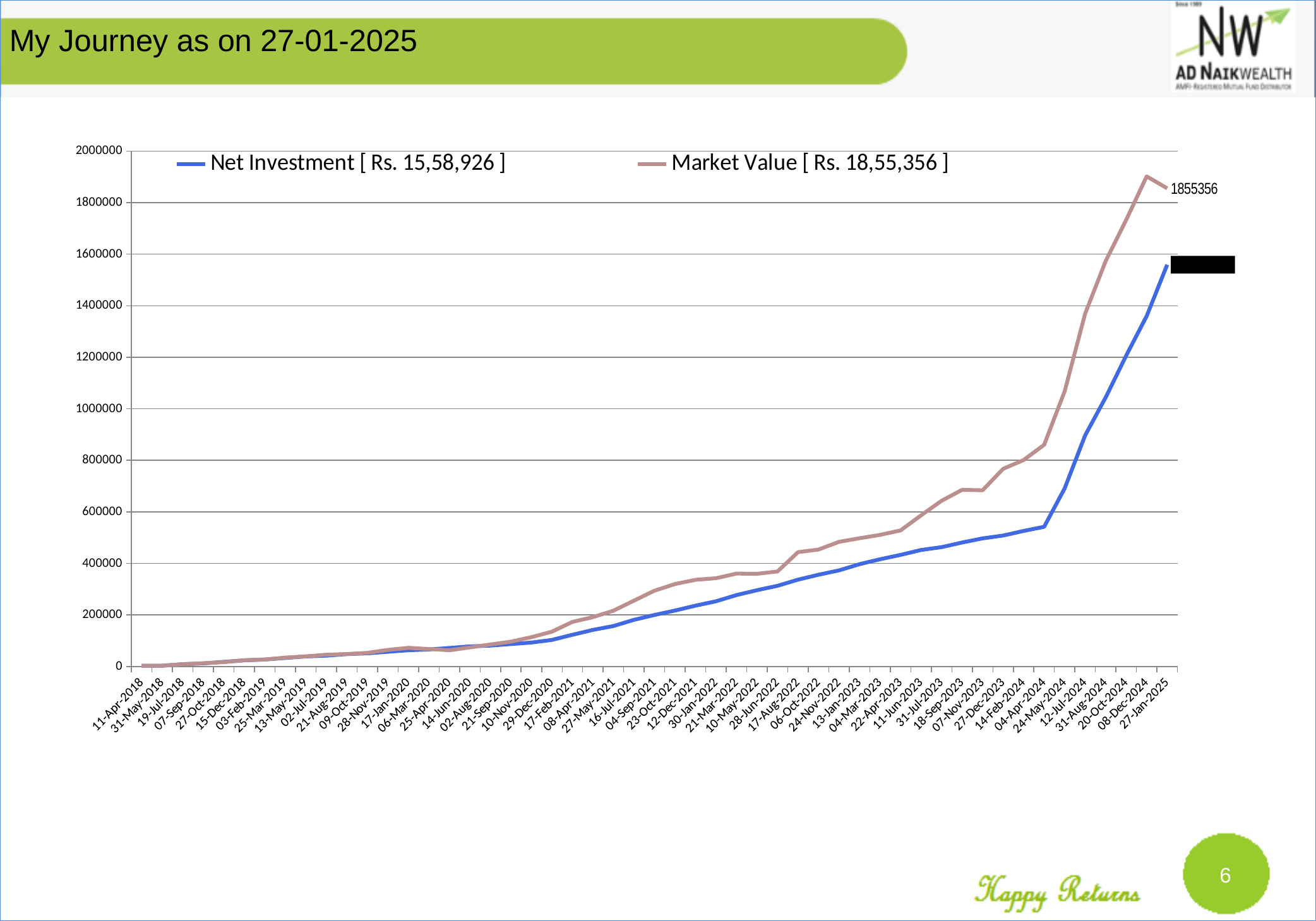
On 27-Jan-2025, which is larger: Market Value or Net Investment? Market Value What is the title of the slide containing the chart? My Journey as on 27-01-2025 What kind of chart is shown on the slide? line chart What Market Value amount is shown in the legend entry? Rs. 18,55,356 Is the Net Investment value on 27-Jan-2025 greater or less than 1400000? greater Is the Market Value on 08-Dec-2024 greater or less than 1800000? greater What Net Investment amount is shown in the legend entry? Rs. 15,58,926 What is the Market Value on 27-Jan-2025 according to the data label at the end of the line? 1855356 What is the difference between the Market Value and the Net Investment shown in the legend? Rs. 2,96,430 Do the Net Investment values generally rise or fall from 11-Apr-2018 to 27-Jan-2025? rise How many series does the chart's legend list? 2 Is the Net Investment value on 04-Apr-2024 greater or less than 600000? less